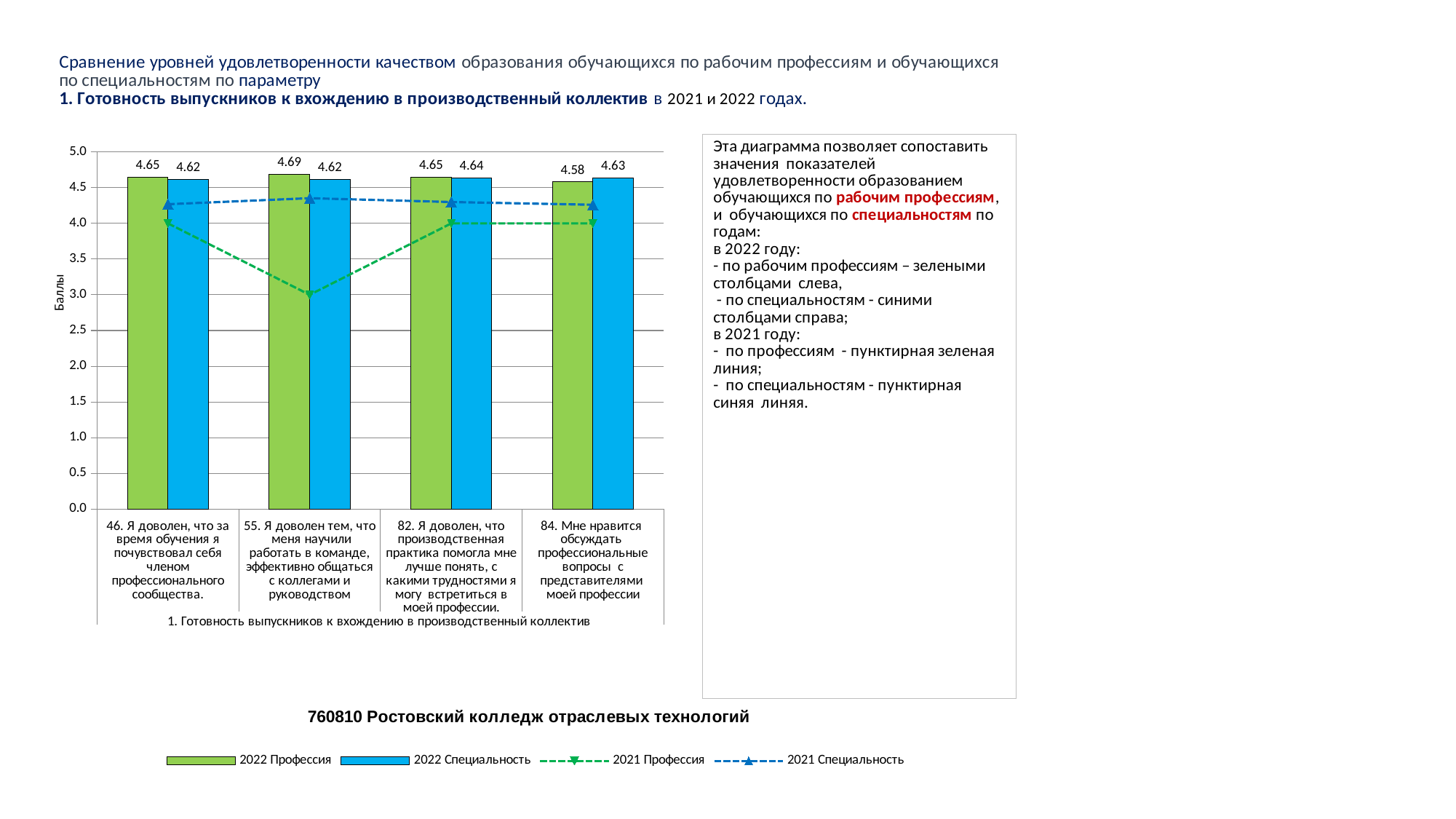
How many items (categories) are shown on the x axis of the chart? 4 What is the label of the vertical axis of the chart? Баллы For item 84, which is larger: the 2022 Профессия value or the 2022 Специальность value? 2022 Специальность How many series does the chart legend list? 4 Is the 2021 Профессия value for item 55 greater or less than 3.5? less Which item has the highest 2022 Профессия bar? 55. Я доволен тем, что меня научили работать в команде, эффективно общаться с коллегами и руководством What is the value of the 2022 Профессия bar for item 55 (Я доволен тем, что меня научили работать в команде...)? 4.69 Is the 2021 Специальность value for item 46 greater or less than 4.0? greater What is the value of the 2022 Профессия bar for item 46? 4.65 What is the value of the 2022 Специальность bar for item 84 (Мне нравится обсуждать профессиональные вопросы...)? 4.63 Which item has the lowest 2022 Профессия bar? 84. Мне нравится обсуждать профессиональные вопросы с представителями моей профессии For item 55, what is the difference between the 2022 Профессия and 2022 Специальность values? 0.07